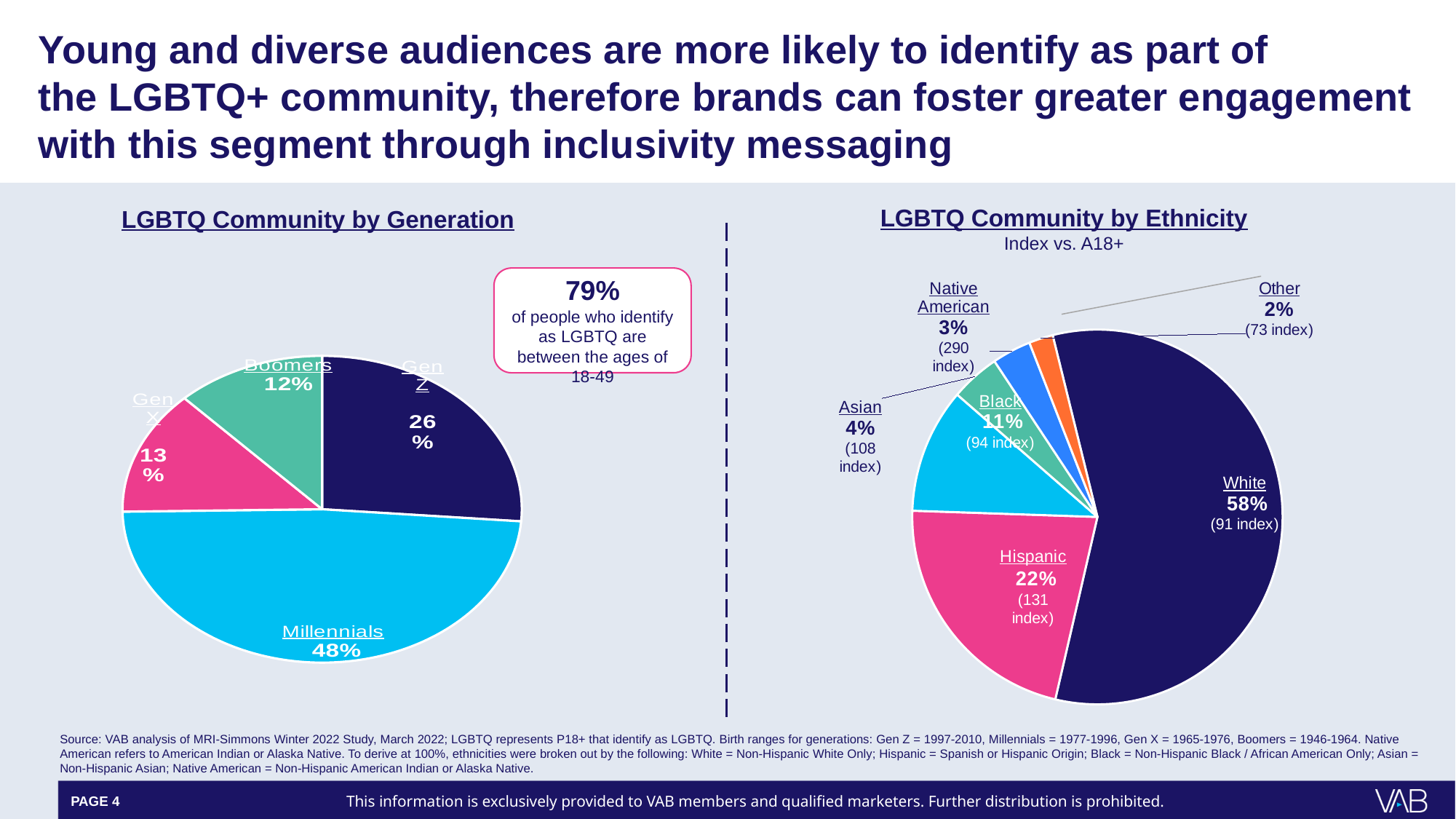
What kind of chart is 'LGBTQ Community by Ethnicity'? Pie chart In the 'LGBTQ Community by Generation' chart, what share do Millennials represent? 48% In the 'LGBTQ Community by Generation' chart, what is the difference between the Gen Z and Gen X shares? 13% In the 'LGBTQ Community by Generation' chart, what share does Gen Z represent? 26% In the 'LGBTQ Community by Ethnicity' chart, what is the index for Native American? 290 index In the 'LGBTQ Community by Ethnicity' chart, what share does Hispanic represent? 22% In the 'LGBTQ Community by Ethnicity' chart, which ethnicity has the largest share? White In the 'LGBTQ Community by Generation' chart, which generation has the largest share? Millennials In the 'LGBTQ Community by Ethnicity' chart, which is larger, the Black share or the Asian share? Black In the 'LGBTQ Community by Generation' chart, how many generations are shown? 4 In the 'LGBTQ Community by Ethnicity' chart, how many ethnicity categories are shown? 6 In the 'LGBTQ Community by Generation' chart, which generation has the smallest share? Boomers